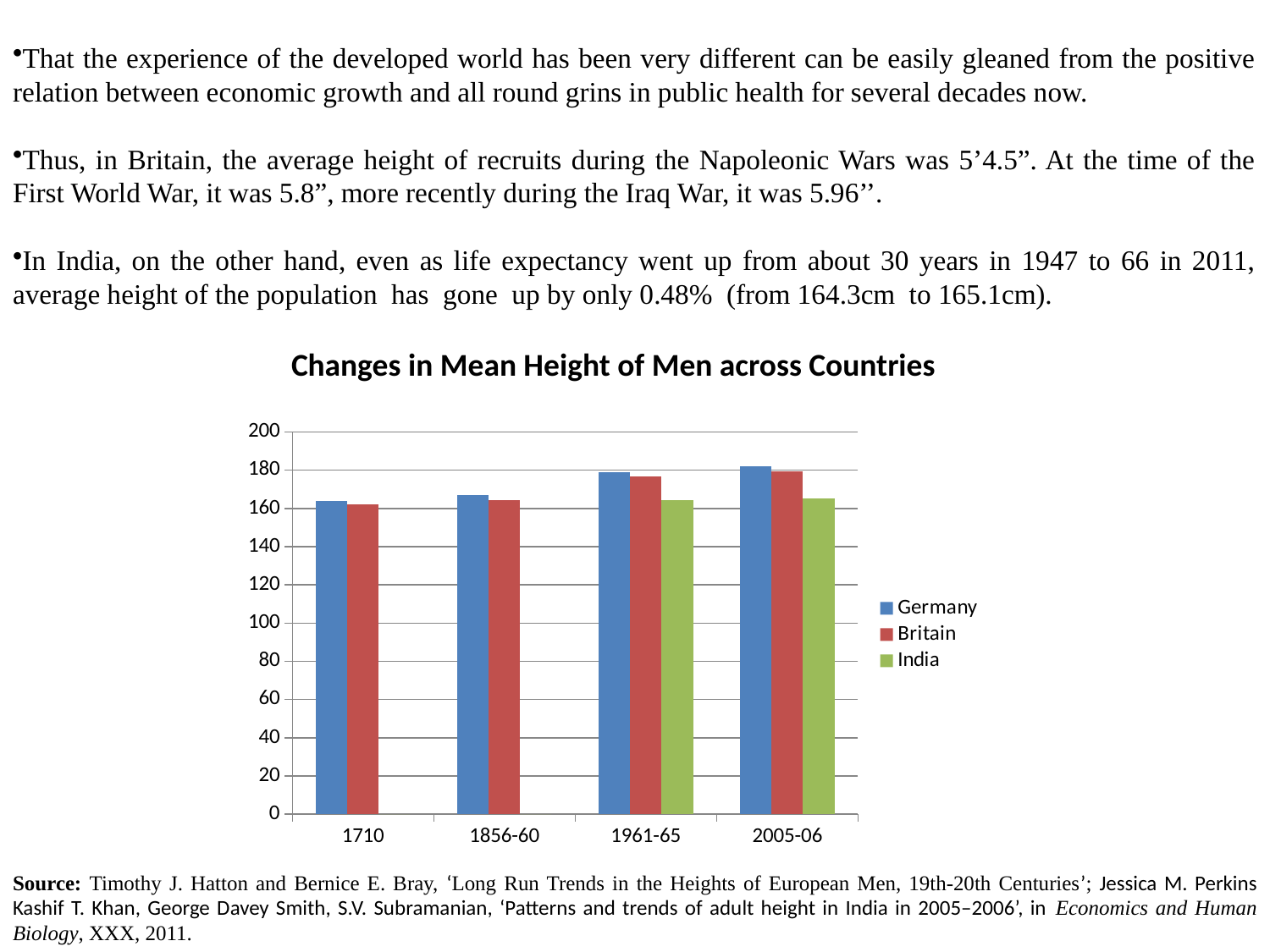
Is the value for Britain in 1710 greater or less than 160? greater Is the value for India in 2005-06 greater or less than 180? less Which country has the lowest bar in the 2005-06 period? India Is the value for Britain in 1961-65 greater or less than 180? less What is the title of the chart? Changes in Mean Height of Men across Countries How many series does the chart's legend list? 3 What kind of chart is shown on the slide? bar chart Which country has no bars for the 1710 and 1856-60 periods? India How many time periods are shown on the x axis of the chart? 4 In 1961-65, which is larger, the value for Britain or the value for India? Britain Do the values for Germany rise or fall from 1710 to 2005-06? rise